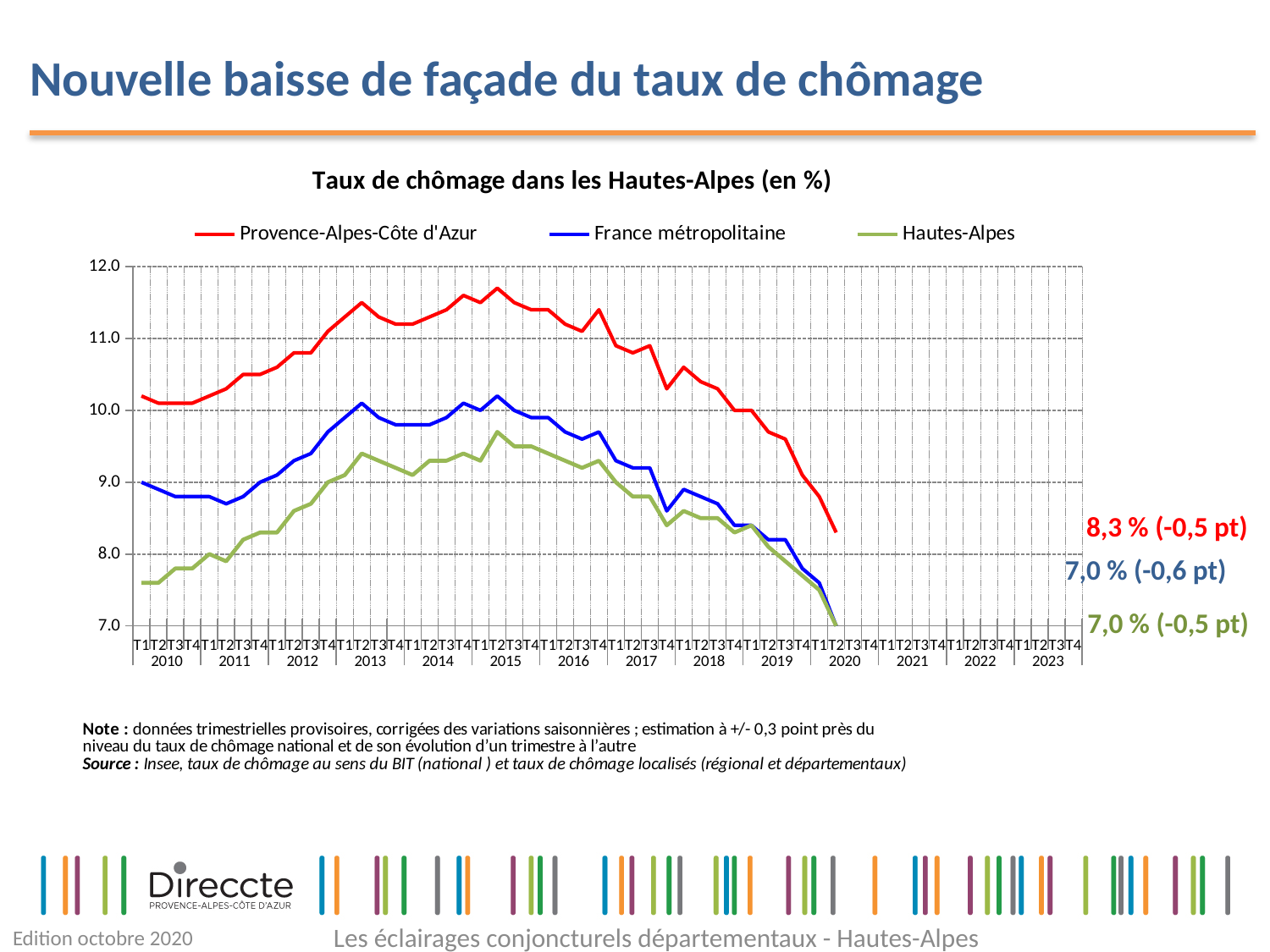
By how many points did the France métropolitaine rate change in the latest quarter, according to the label? -0,6 pt What is the latest unemployment rate shown for Provence-Alpes-Côte d'Azur? 8,3 % What is the title of the chart? Taux de chômage dans les Hautes-Alpes (en %) Is the Provence-Alpes-Côte d'Azur rate in T2 2015 greater or less than 11.0? greater What is the latest unemployment rate shown for France métropolitaine? 7,0 % How many series does the legend list? 3 Is the Hautes-Alpes rate in T1 2010 greater or less than 8.0? less What is the latest unemployment rate shown for Hautes-Alpes? 7,0 % From 2015 to 2020, does the Provence-Alpes-Côte d'Azur unemployment rate rise or fall overall? Fall What kind of chart is shown on the slide? Line chart What is the difference between the latest Provence-Alpes-Côte d'Azur rate and the latest France métropolitaine rate? 1,3 points Which series has the highest latest value? Provence-Alpes-Côte d'Azur